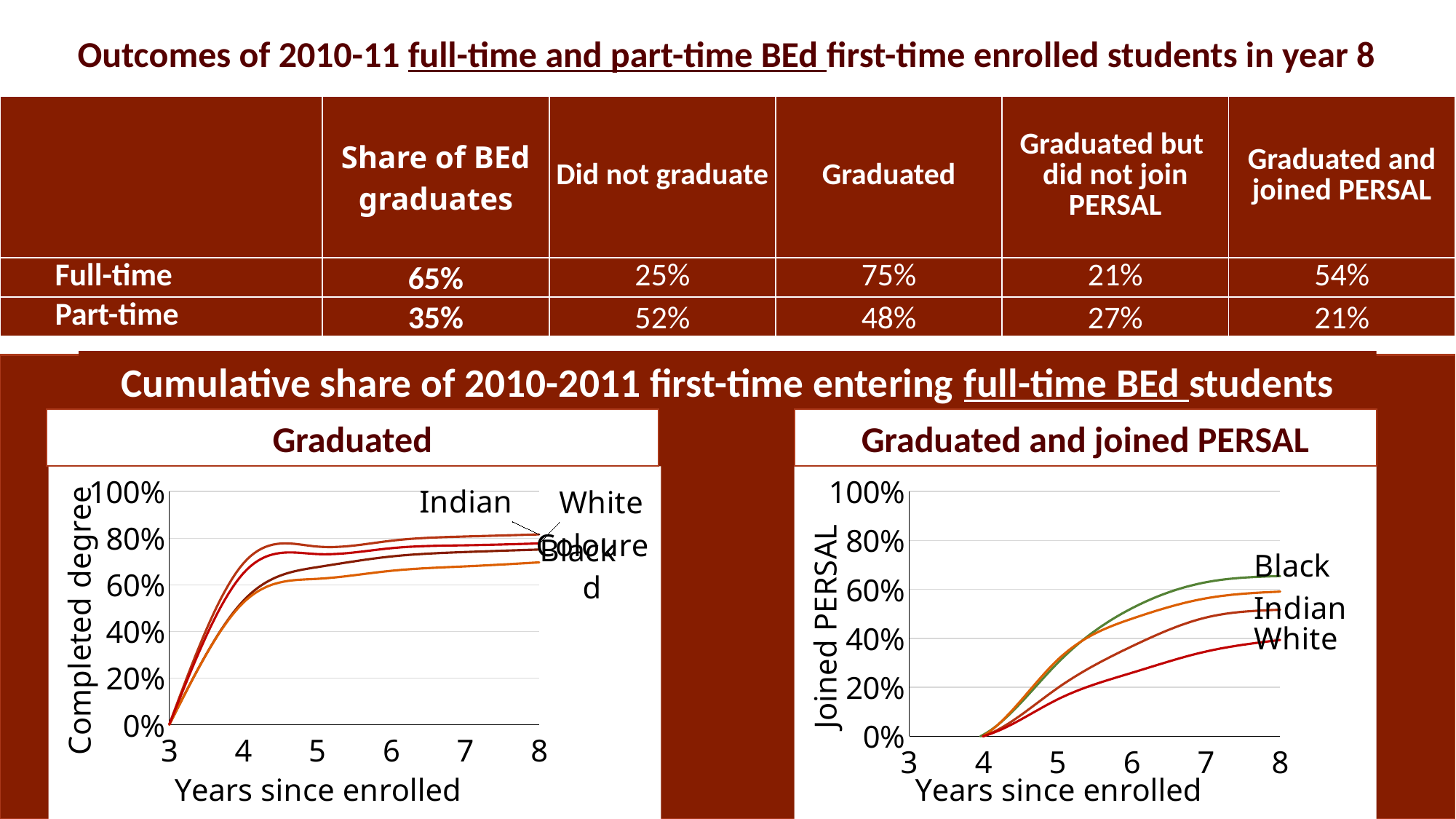
In the "Graduated and joined PERSAL" chart, is the value for Black at 8 years since enrolled greater or less than 60%? greater In the "Graduated and joined PERSAL" chart, which is larger at 8 years since enrolled, Black or White? Black In the "Graduated and joined PERSAL" chart, which group has the highest value at 8 years since enrolled? Black What kind of chart is the "Graduated" chart on the left? line chart How many groups are labelled in the "Graduated" chart? 4 In the "Graduated and joined PERSAL" chart, do the lines rise or fall as years since enrolled increase? rise What is the x-axis title of the "Graduated" chart? Years since enrolled In the "Graduated" chart, is the value for Black at 8 years since enrolled greater or less than 60%? greater What kind of chart is the "Graduated and joined PERSAL" chart on the right? line chart What is the y-axis title of the "Graduated and joined PERSAL" chart? Joined PERSAL In the "Graduated and joined PERSAL" chart, which labelled group has the lowest value at 8 years since enrolled? White